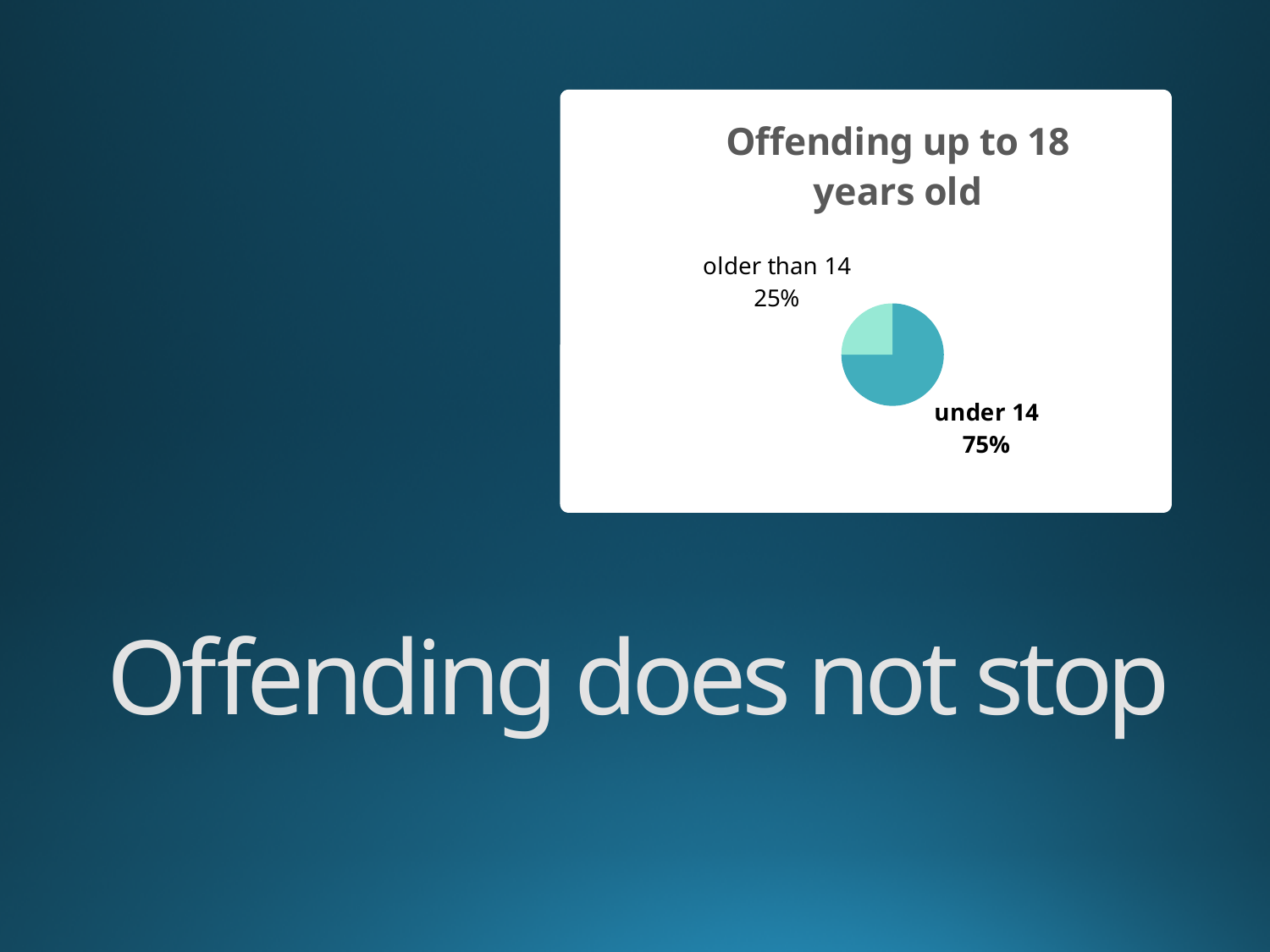
What is the title of the chart? Offending up to 18 years old What kind of chart is shown on the slide? pie chart What is the difference in percentage points between the "under 14" and "older than 14" slices? 50 Is the share for "older than 14" greater or less than 50%? less How many slices does the pie chart have? 2 Which slice of the pie is the largest? under 14 Which slice of the pie is the smallest? older than 14 Which slice is shown in the lighter colour? older than 14 What share of the pie is labelled "older than 14"? 25% What share of the pie is labelled "under 14"? 75% Which is larger, the "under 14" slice or the "older than 14" slice? under 14